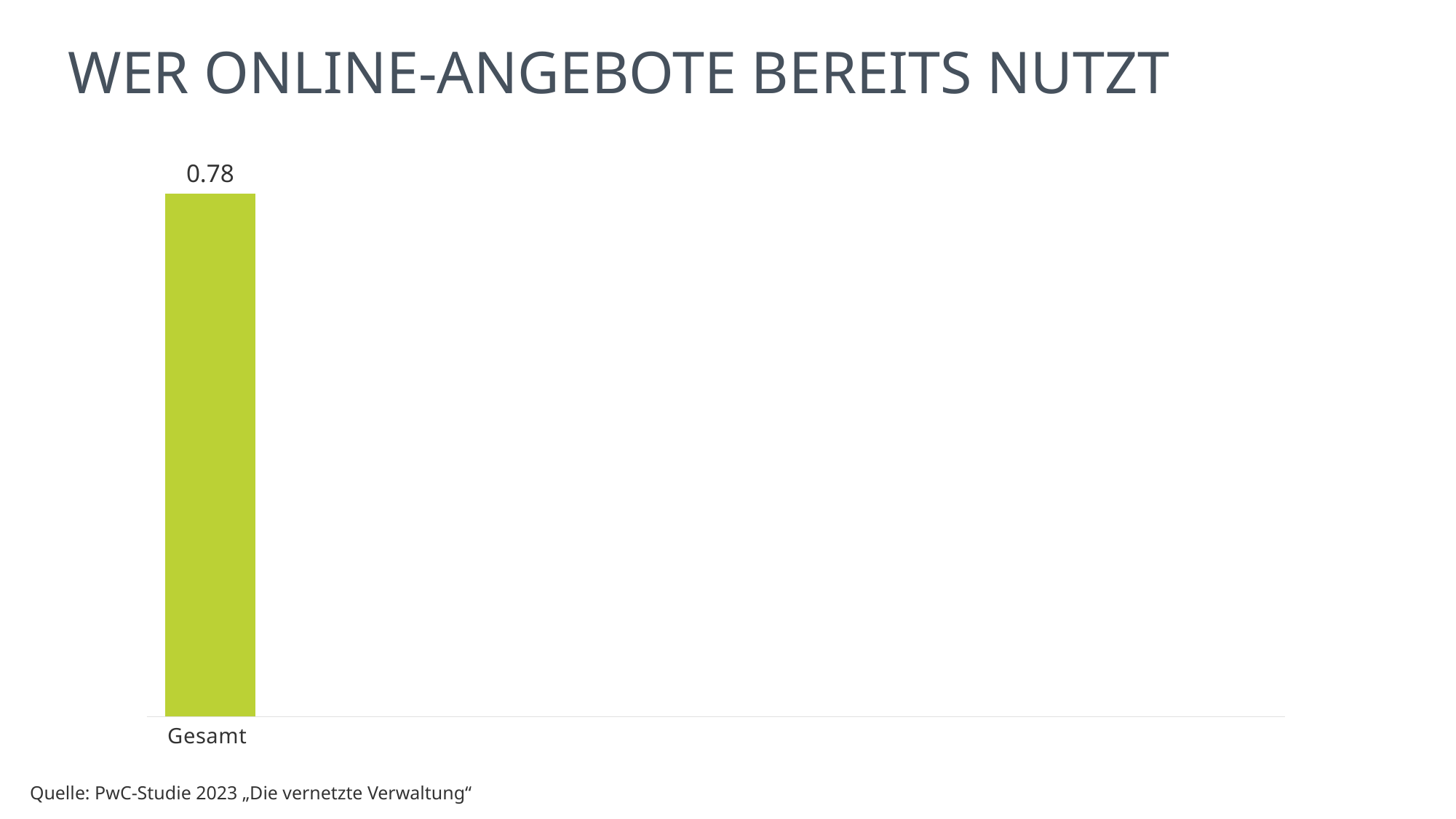
What is the value shown for Gesamt? 0.78 What kind of chart is shown on the slide? bar chart How many bars are plotted in the chart? 1 What is the label of the only category on the x axis? Gesamt What is the title of the slide containing the chart? WER ONLINE-ANGEBOTE BEREITS NUTZT